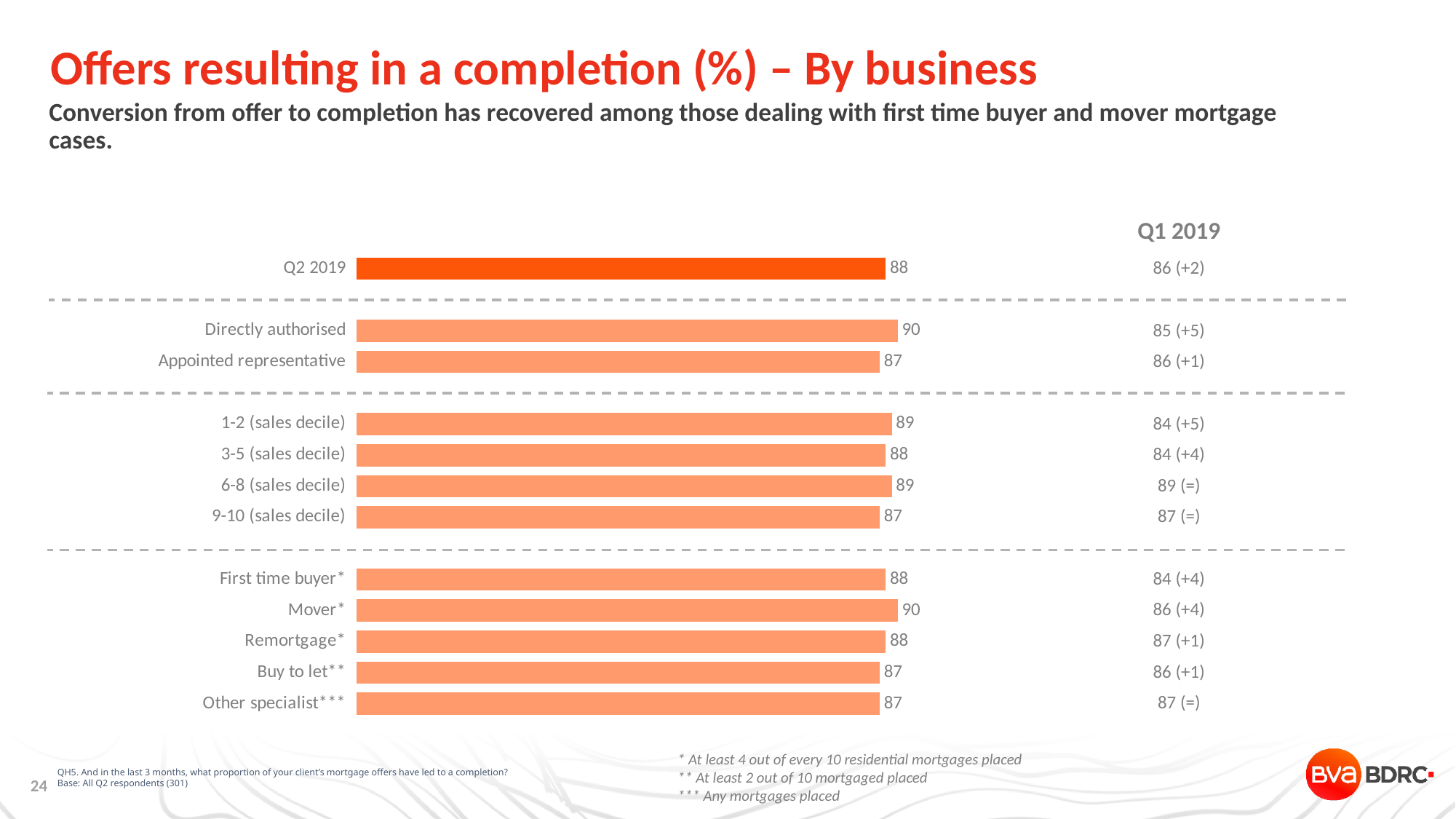
What is the Q2 2019 value for the 1-2 (sales decile) group? 89 What Q1 2019 value is listed for First time buyer? 84 (+4) Which has the larger value, Mover or Buy to let? Mover What is the Q2 2019 value for Other specialist? 87 What is the title of the slide's chart? Offers resulting in a completion (%) – By business What is the difference between the Directly authorised value and the Appointed representative value? 3 What is the Q2 2019 value for Mover? 90 What is the highest value shown on the bars? 90 What kind of chart is shown on the slide? Bar chart What is the Q2 2019 value for Appointed representative? 87 What is the Q2 2019 value for Directly authorised? 90 How many bars are plotted on the chart? 12